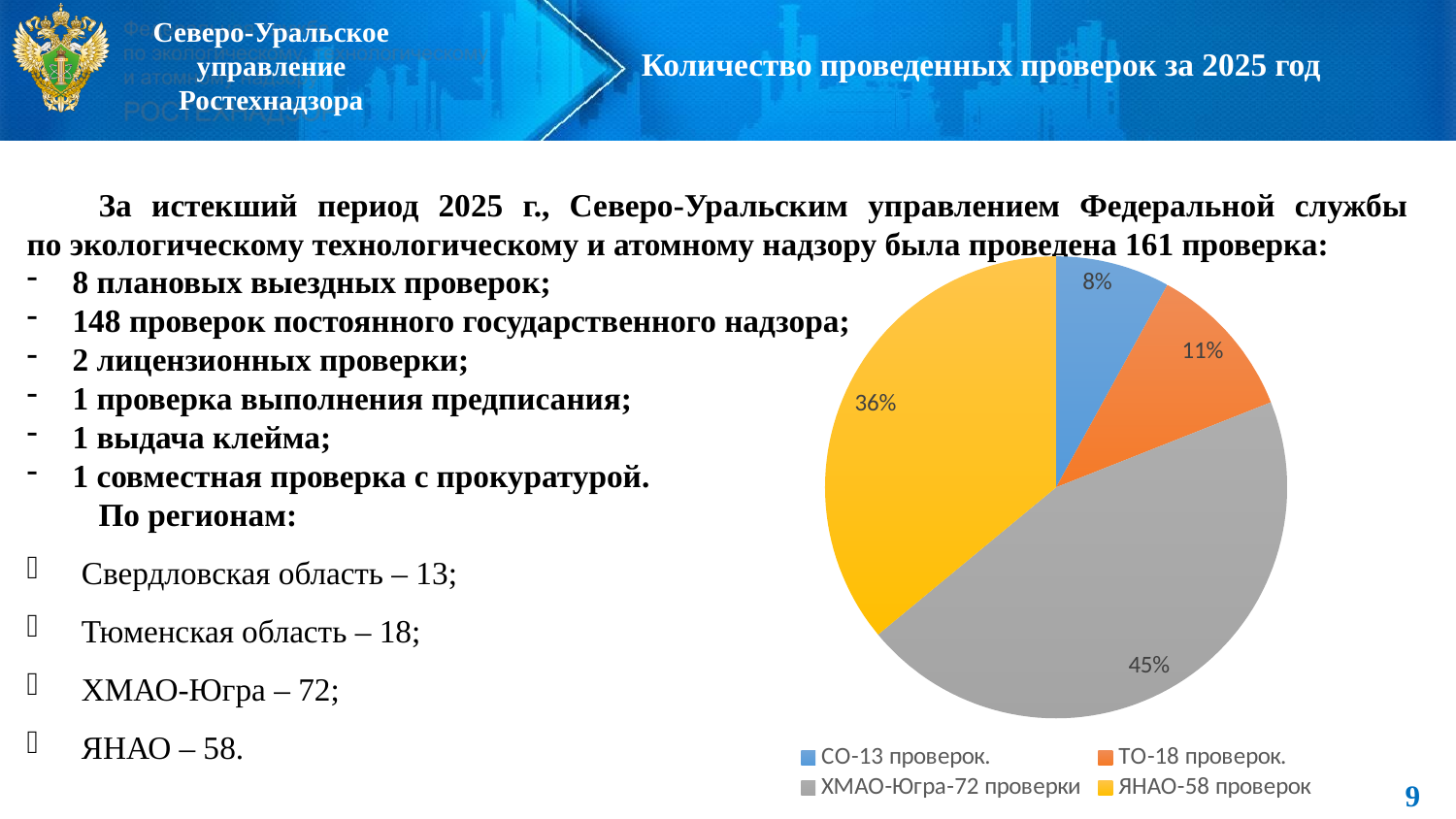
Which slice of the pie chart is the smallest? СО-13 проверок What kind of chart is shown on the slide? pie chart How many slices does the pie chart have? 4 How many entries does the legend of the pie chart list? 4 What share of the pie does the slice for ЯНАО-58 проверок represent? 36% What is the difference in percentage points between the ХМАО-Югра slice and the ЯНАО slice? 9 What share of the pie does the slice for СО-13 проверок represent? 8% What colour is the slice for ЯНАО-58 проверок in the pie chart? yellow Which slice is larger, ТО-18 проверок or СО-13 проверок? ТО-18 проверок What share of the pie does the slice for ТО-18 проверок represent? 11% Which slice of the pie chart is the largest? ХМАО-Югра-72 проверки